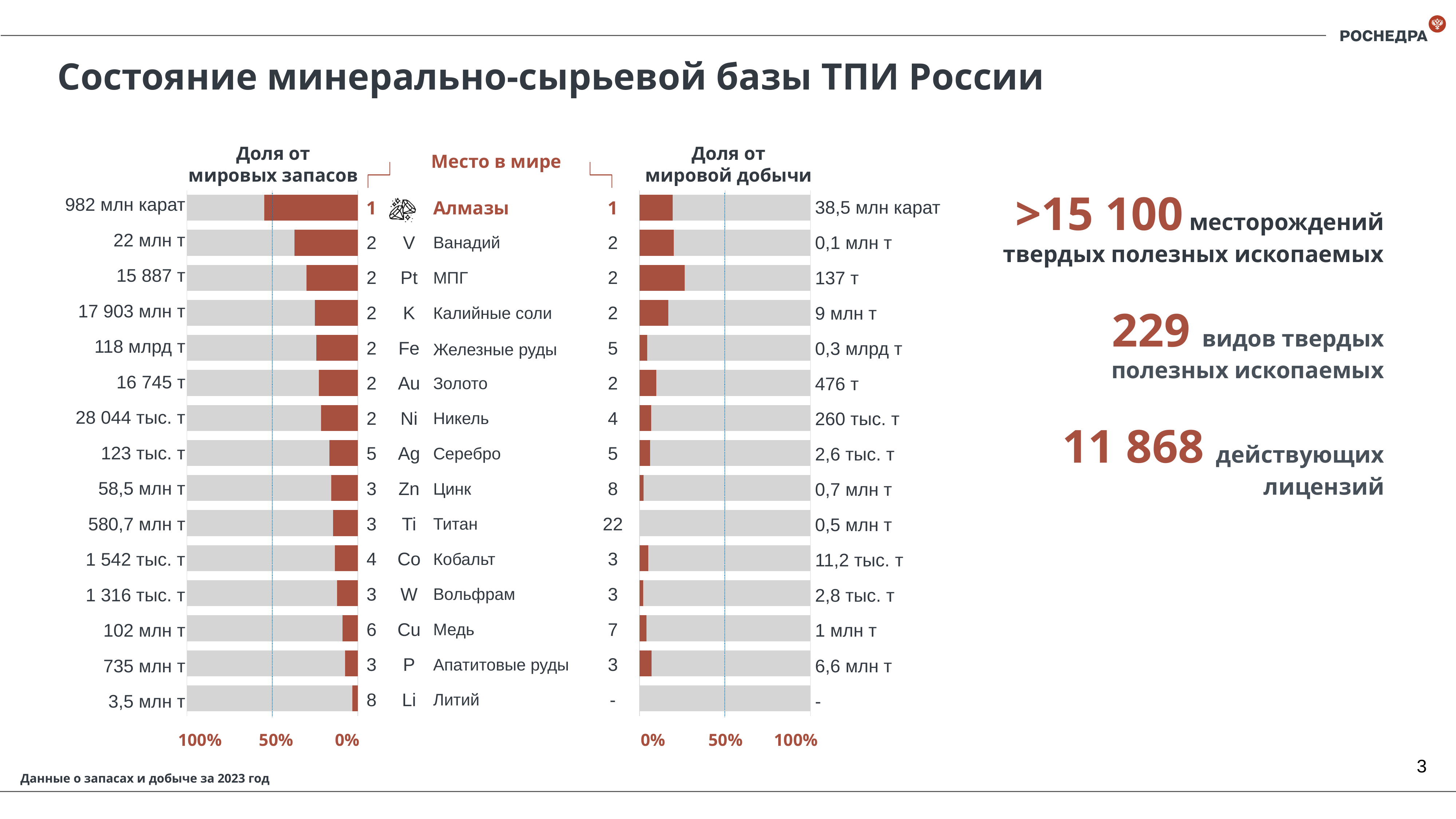
In the "Доля от мировой добычи" chart, which mineral has the largest share of world production? МПГ In the "Доля от мировых запасов" chart, what is the reserves value printed for Золото? 16 745 т In the "Доля от мировой добычи" chart, what world rank (Место в мире) is printed for Титан? 22 In the "Доля от мировой добычи" chart, what is the production value printed for Алмазы? 38,5 млн карат In the "Доля от мировых запасов" chart, which has the larger share of world reserves, Ванадий or Медь? Ванадий In the "Доля от мировой добычи" chart, is the share for МПГ greater or less than 50%? less In the "Доля от мировых запасов" chart, what world rank (Место в мире) is printed for Литий? 8 In the "Доля от мировых запасов" chart, is the share for Алмазы greater or less than 50%? greater In the "Доля от мировых запасов" chart, which mineral has the smallest share of world reserves? Литий How many minerals are listed in the "Доля от мировых запасов" chart? 15 In the "Доля от мировых запасов" chart, which mineral has the largest share of world reserves? Алмазы What kind of chart is used for "Доля от мировых запасов"? bar chart